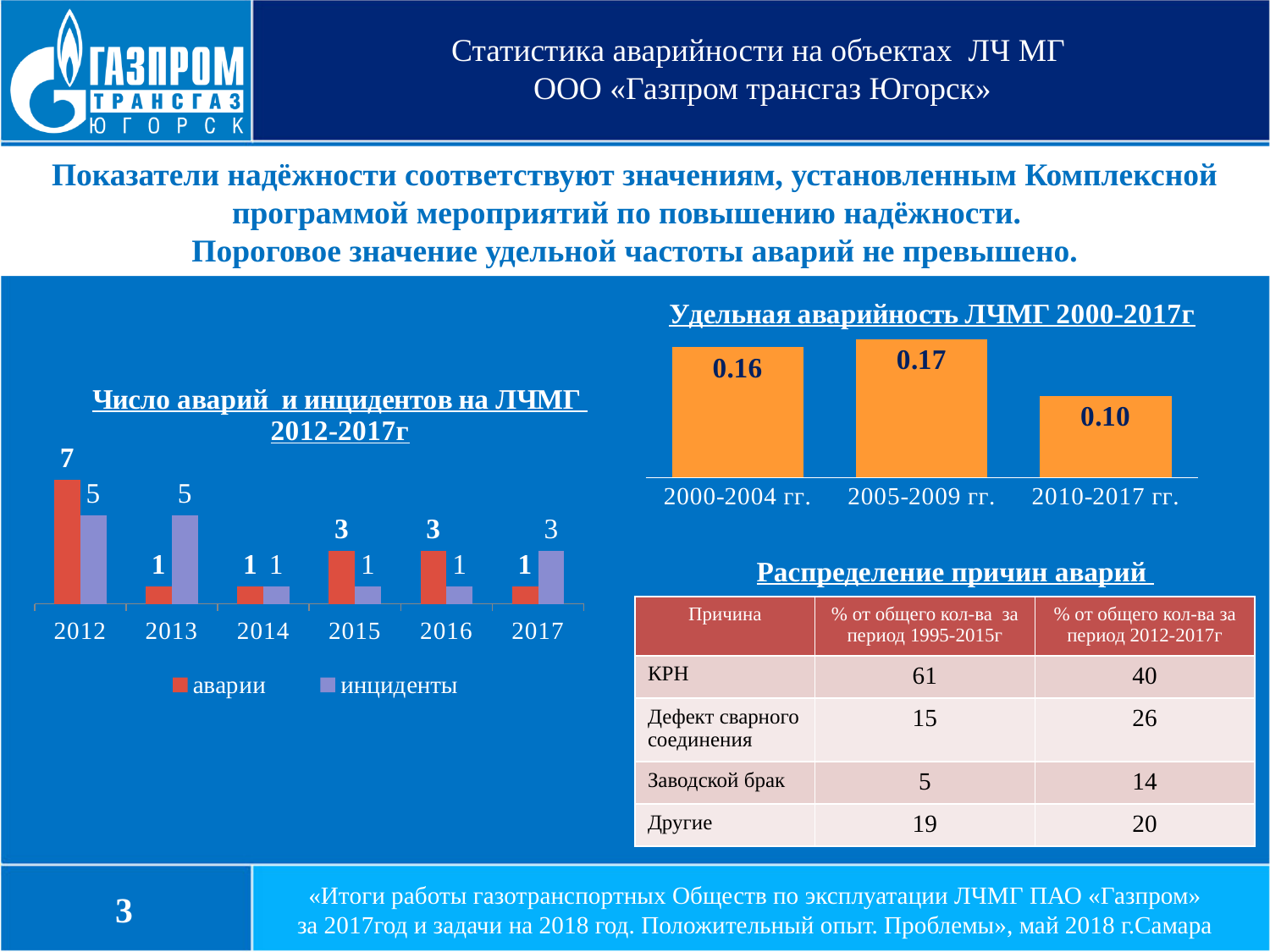
In the chart 'Число аварий и инцидентов на ЛЧМГ 2012-2017г', what is the value for аварии in 2012? 7 In the chart 'Удельная аварийность ЛЧМГ 2000-2017г', which period has the lowest value? 2010-2017 гг. How many years are shown on the x axis of the chart 'Число аварий и инцидентов на ЛЧМГ 2012-2017г'? 6 In the chart 'Число аварий и инцидентов на ЛЧМГ 2012-2017г', what is the difference between аварии and инциденты in 2012? 2 How many series does the legend of the chart 'Число аварий и инцидентов на ЛЧМГ 2012-2017г' list? 2 In the chart 'Число аварий и инцидентов на ЛЧМГ 2012-2017г', what is the value for инциденты in 2017? 3 How many bars are in the chart 'Удельная аварийность ЛЧМГ 2000-2017г'? 3 What kind of chart is 'Число аварий и инцидентов на ЛЧМГ 2012-2017г'? bar chart In the chart 'Удельная аварийность ЛЧМГ 2000-2017г', what is the difference between the values for 2005-2009 гг. and 2010-2017 гг.? 0.07 In the chart 'Удельная аварийность ЛЧМГ 2000-2017г', what is the value for 2005-2009 гг.? 0.17 In the chart 'Число аварий и инцидентов на ЛЧМГ 2012-2017г', which year has the highest value for аварии? 2012 In the chart 'Число аварий и инцидентов на ЛЧМГ 2012-2017г', which is larger in 2013: аварии or инциденты? инциденты